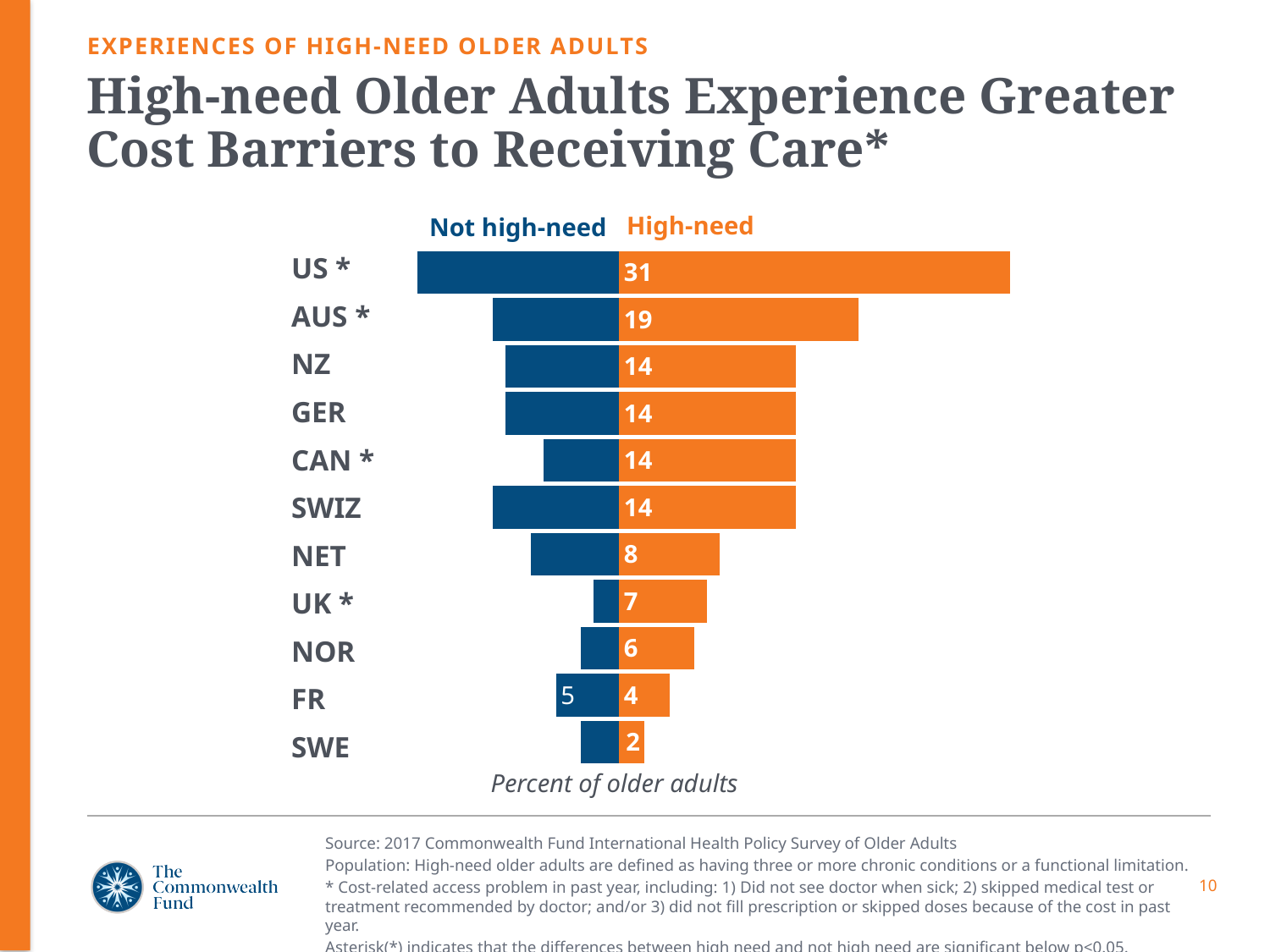
What type of chart is shown on the slide? Bar chart What is the High-need value for SWE? 2 Which has the larger High-need value, NET or UK? NET What is the High-need value for AUS? 19 What is the Not high-need value for FR? 5 How many countries are shown in the chart? 11 What is the difference between the High-need values for US and AUS? 12 How many series does the chart show? 2 Which country has the highest High-need value? US What is the High-need value for NOR? 6 What is the High-need value for US? 31 Which country has the lowest High-need value? SWE